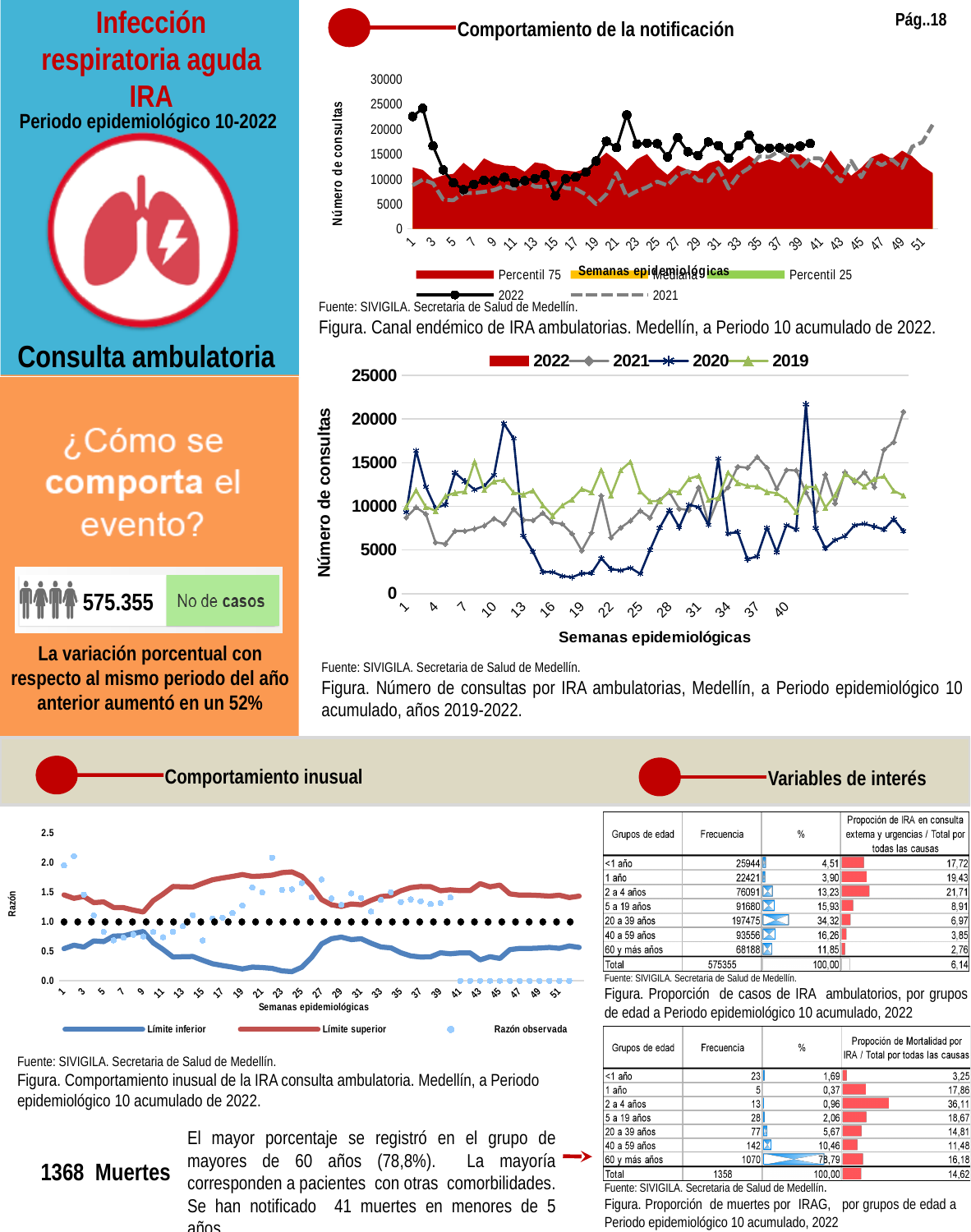
In the chart titled 'Comportamiento de la notificación' (top), how many entries does the legend list? 5 In the 'Comportamiento inusual' chart at the bottom left, is the value of the Límite superior series at week 23 greater or less than 1.5? greater In the middle chart showing consultations for years 2019-2022, is the value of the 2020 series at week 10 greater or less than 15000? less In the middle chart showing consultations for years 2019-2022, how many series does the legend list? 4 In the chart titled 'Comportamiento de la notificación' (top), is the value of the 2022 series at week 5 greater or less than 10000? less In the chart titled 'Comportamiento de la notificación' (top), does the 2022 series rise or fall between week 1 and week 5? fall In the middle chart showing consultations for years 2019-2022, which series has the higher value at week 19: 2019 or 2020? 2019 In the chart titled 'Comportamiento de la notificación' (top), what is the label of the y axis? Número de consultas In the middle chart showing consultations for years 2019-2022, what is the highest value shown on the y axis? 25000 What kind of chart is the 'Comportamiento inusual' chart at the bottom left? line chart